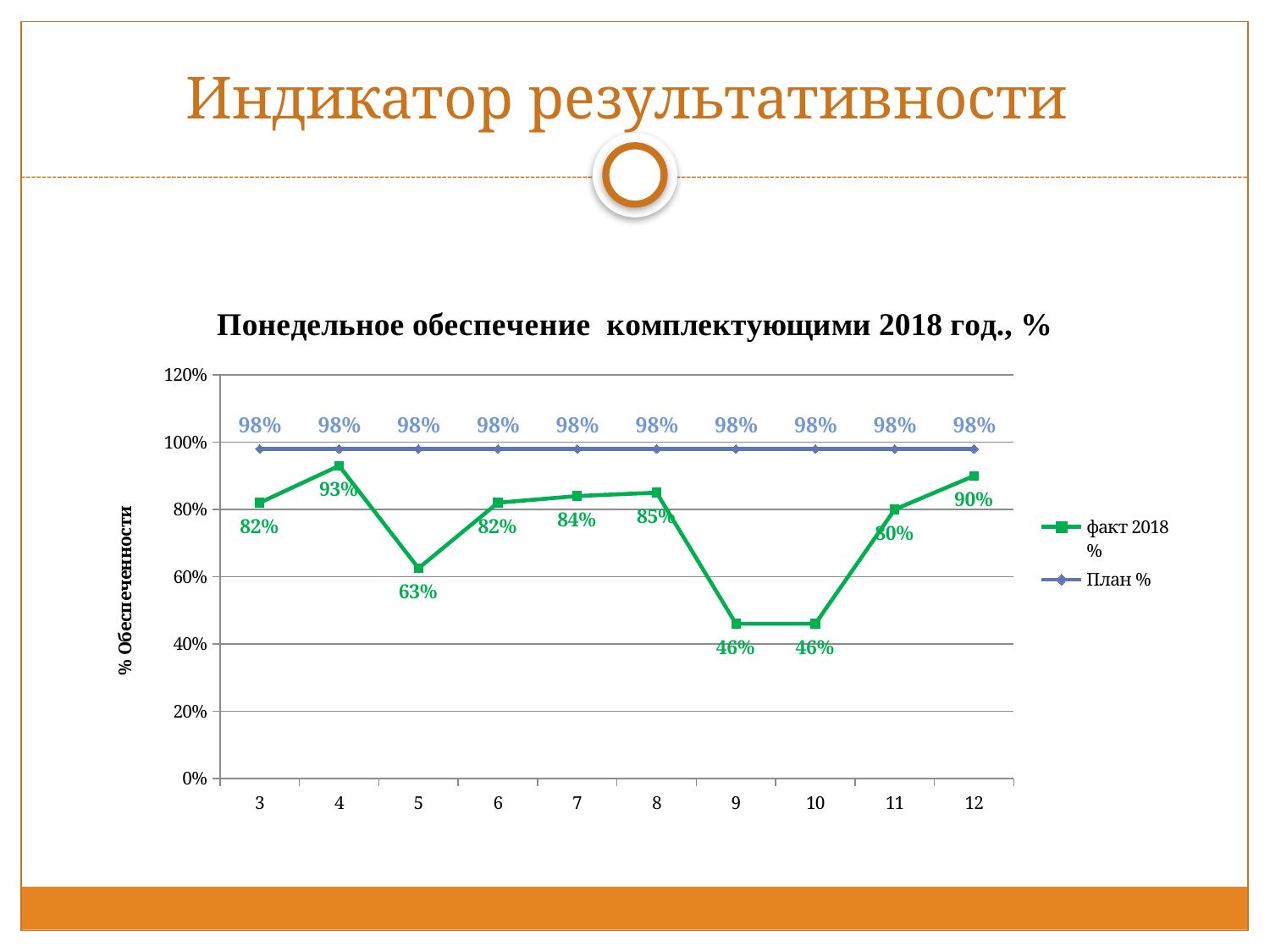
What is the value of факт 2018 % for week 5? 63% What is the value of План % for week 7? 98% How many weeks are plotted on the x axis? 10 What is the lowest факт 2018 % value shown on the chart? 46% Which is larger, the факт 2018 % value for week 4 or for week 11? week 4 What is the title of the chart? Понедельное обеспечение комплектующими 2018 год., % Is the факт 2018 % value for week 10 greater or less than 60%? less What kind of chart is shown on the slide? line chart What is the value of факт 2018 % for week 12? 90% Which week has the highest факт 2018 % value? 4 What is the difference between План % and факт 2018 % for week 9? 52% How many series does the legend list? 2